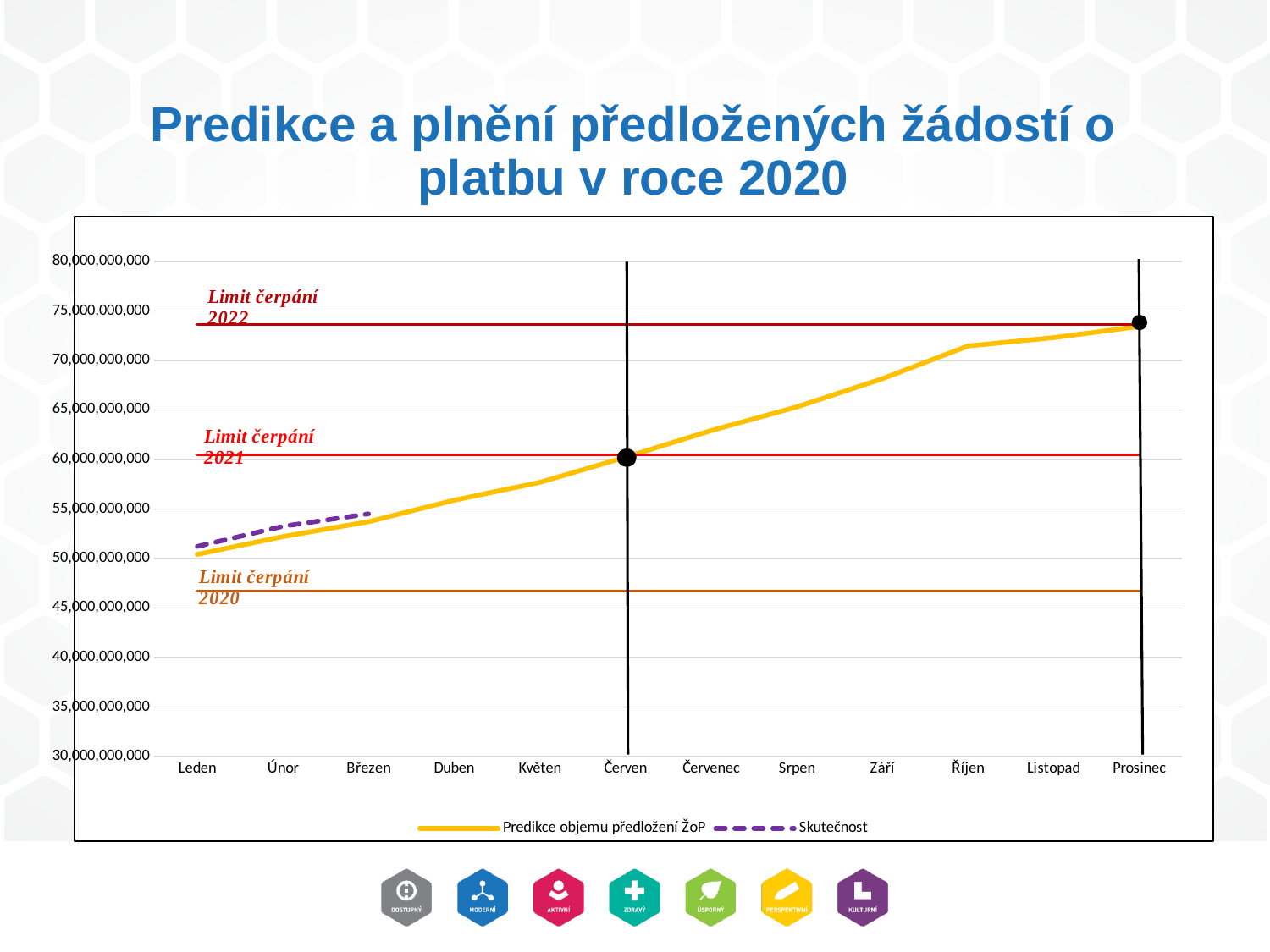
In which month is the 'Predikce objemu předložení ŽoP' series highest? Prosinec What is the title of the slide containing the chart? Predikce a plnění předložených žádostí o platbu v roce 2020 Is the value of 'Predikce objemu předložení ŽoP' in Leden greater or less than 55,000,000,000? less How many series does the legend list? 2 Is the value of 'Skutečnost' in Leden greater or less than 50,000,000,000? greater How many months are shown on the x axis? 12 What kind of chart is shown on the slide? line chart Does the 'Predikce objemu předložení ŽoP' series rise or fall from Leden to Prosinec? rise Is the value of 'Predikce objemu předložení ŽoP' in Prosinec greater or less than 70,000,000,000? greater In Únor, which series has the higher value: 'Predikce objemu předložení ŽoP' or 'Skutečnost'? Skutečnost In which month is the 'Predikce objemu předložení ŽoP' series lowest? Leden Which series is drawn as a dashed purple line? Skutečnost